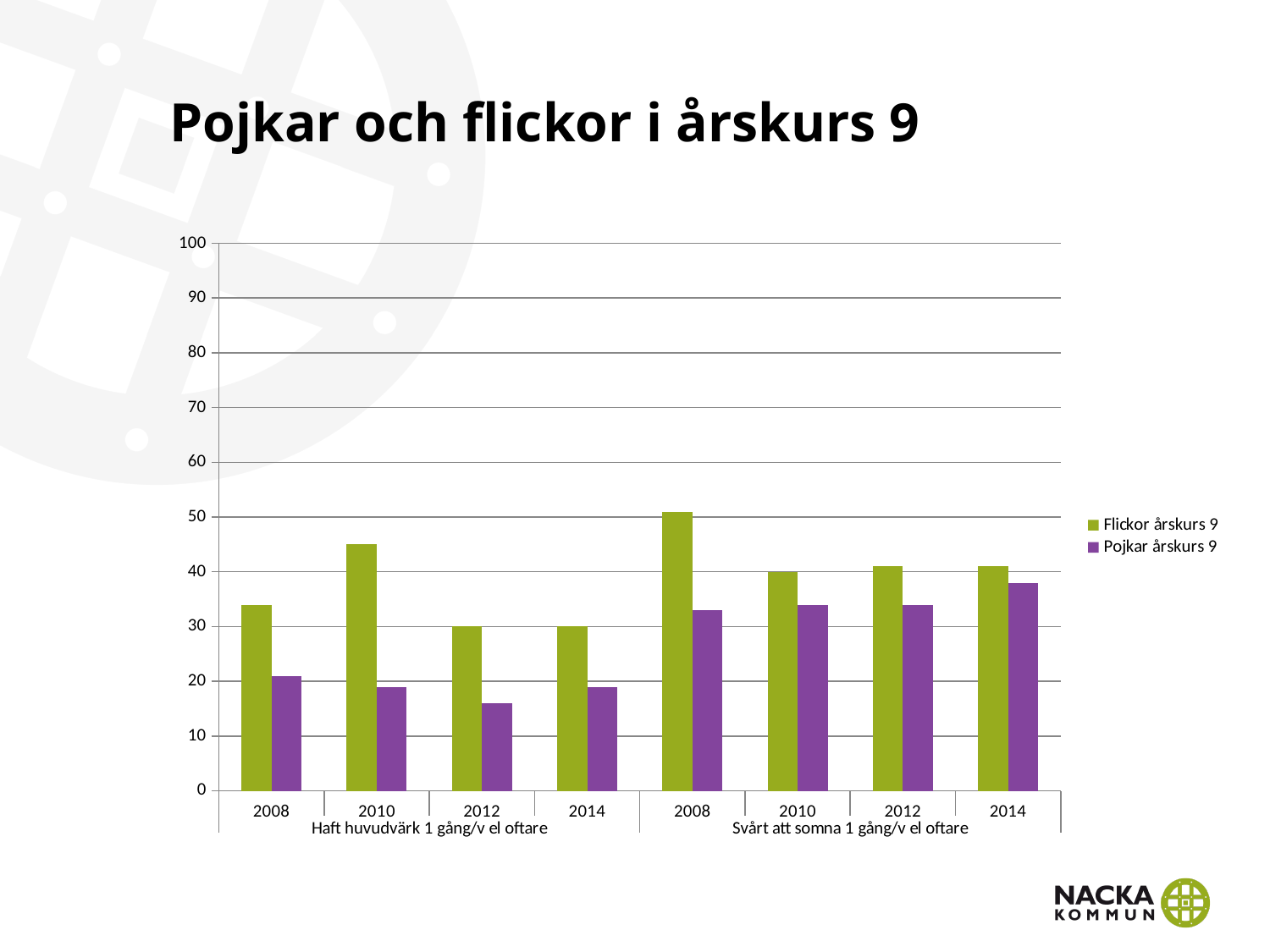
Under 'Svårt att somna 1 gång/v el oftare' in 2014, which is larger: Flickor årskurs 9 or Pojkar årskurs 9? Flickor årskurs 9 What are the two series named in the legend? Flickor årskurs 9 and Pojkar årskurs 9 What type of chart is shown on the slide? bar chart How many year categories are shown under 'Haft huvudvärk 1 gång/v el oftare'? 4 How many series does the legend list? 2 In which year is the Pojkar årskurs 9 bar lowest under 'Haft huvudvärk 1 gång/v el oftare'? 2012 What is the value for Flickor årskurs 9 in 2012 under 'Haft huvudvärk 1 gång/v el oftare'? 30 Is the value for Pojkar årskurs 9 in 2012 under 'Haft huvudvärk 1 gång/v el oftare' greater or less than 20? less In which year is the Flickor årskurs 9 bar highest under 'Haft huvudvärk 1 gång/v el oftare'? 2010 What is the value for Flickor årskurs 9 in 2010 under 'Svårt att somna 1 gång/v el oftare'? 40 What is the title of the slide containing the chart? Pojkar och flickor i årskurs 9